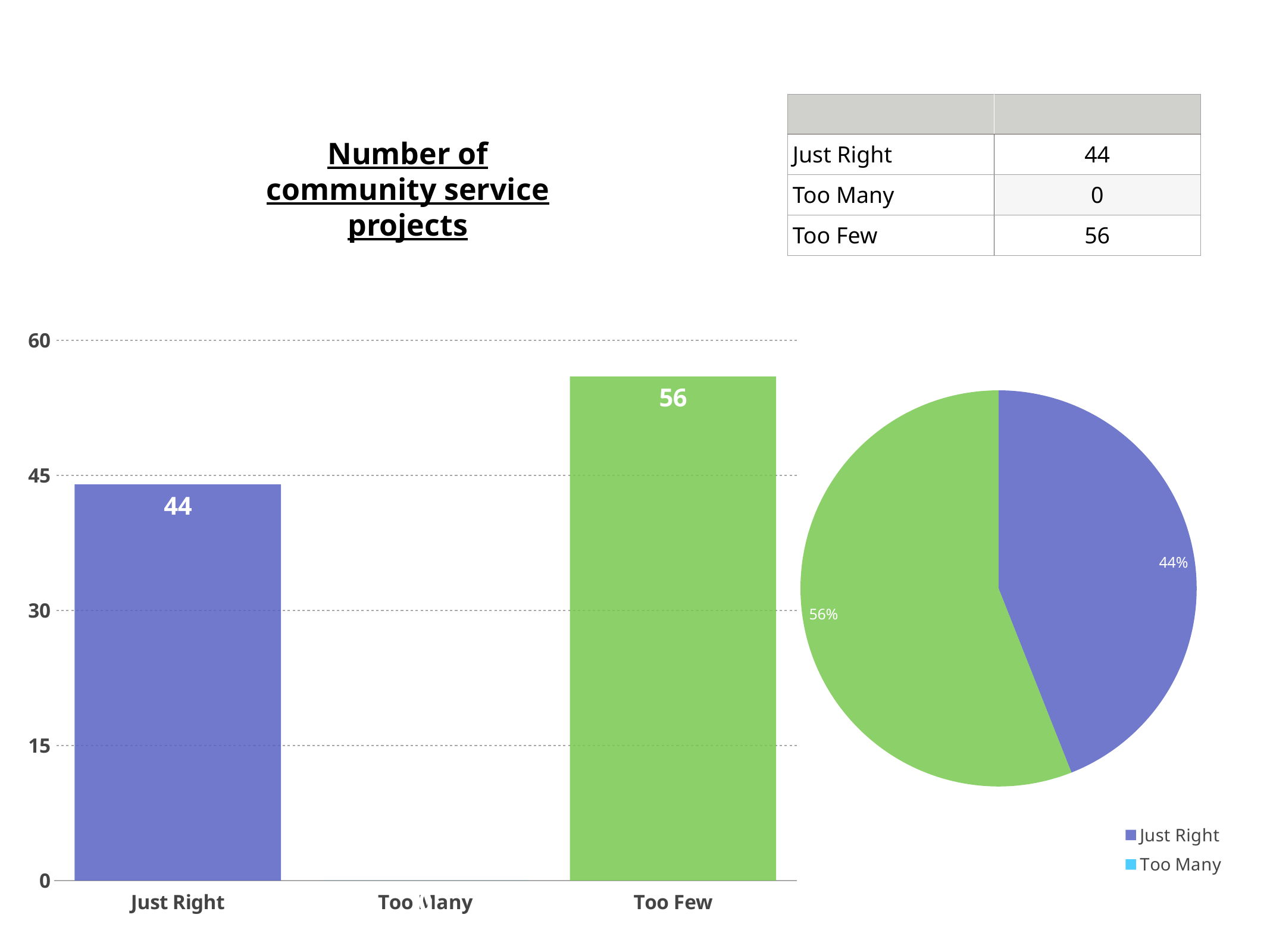
In the bar chart, which is larger, the value for Just Right or the value for Too Few? Too Few In the pie chart, what share of the pie does the Just Right slice represent? 44% In the bar chart, what is the difference between the values for Too Few and Just Right? 12 In the bar chart, what is the value for Just Right? 44 In the bar chart, which category has the highest value? Too Few In the bar chart, what is the value for Too Few? 56 In the bar chart, which category has the lowest value? Too Many What kind of chart is the chart on the left of the slide? bar chart In the bar chart, what is the value for Too Many? 0 In the bar chart, is the value for Just Right greater or less than 45? less How many categories are shown on the x axis of the bar chart? 3 What is the title of the bar chart? Number of community service projects